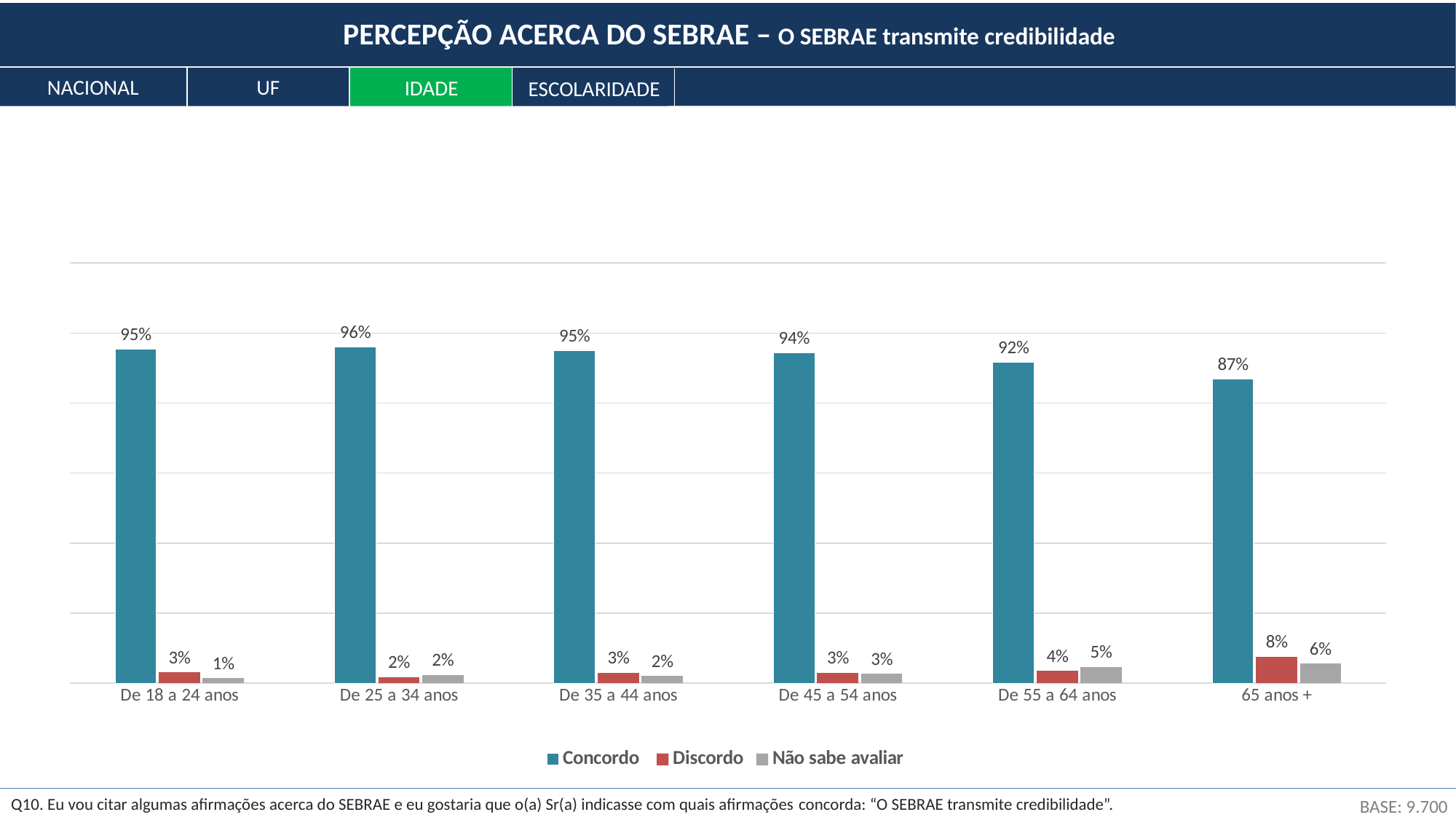
Do the Concordo values rise or fall from De 45 a 54 anos to 65 anos +? Fall What is the Discordo value for 65 anos +? 8% What kind of chart is shown on the slide? Bar chart How many series does the legend list? 3 Which age group has the highest Concordo value? De 25 a 34 anos Which age group has the lowest Concordo value? 65 anos + Which is larger, the Discordo value for De 55 a 64 anos or for De 25 a 34 anos? De 55 a 64 anos Which tab is highlighted in green in the navigation bar? IDADE How many age groups are shown on the x axis? 6 What is the Não sabe avaliar value for De 55 a 64 anos? 5% What is the Concordo value for De 25 a 34 anos? 96% What is the difference between the Concordo values for De 18 a 24 anos and 65 anos +? 8%